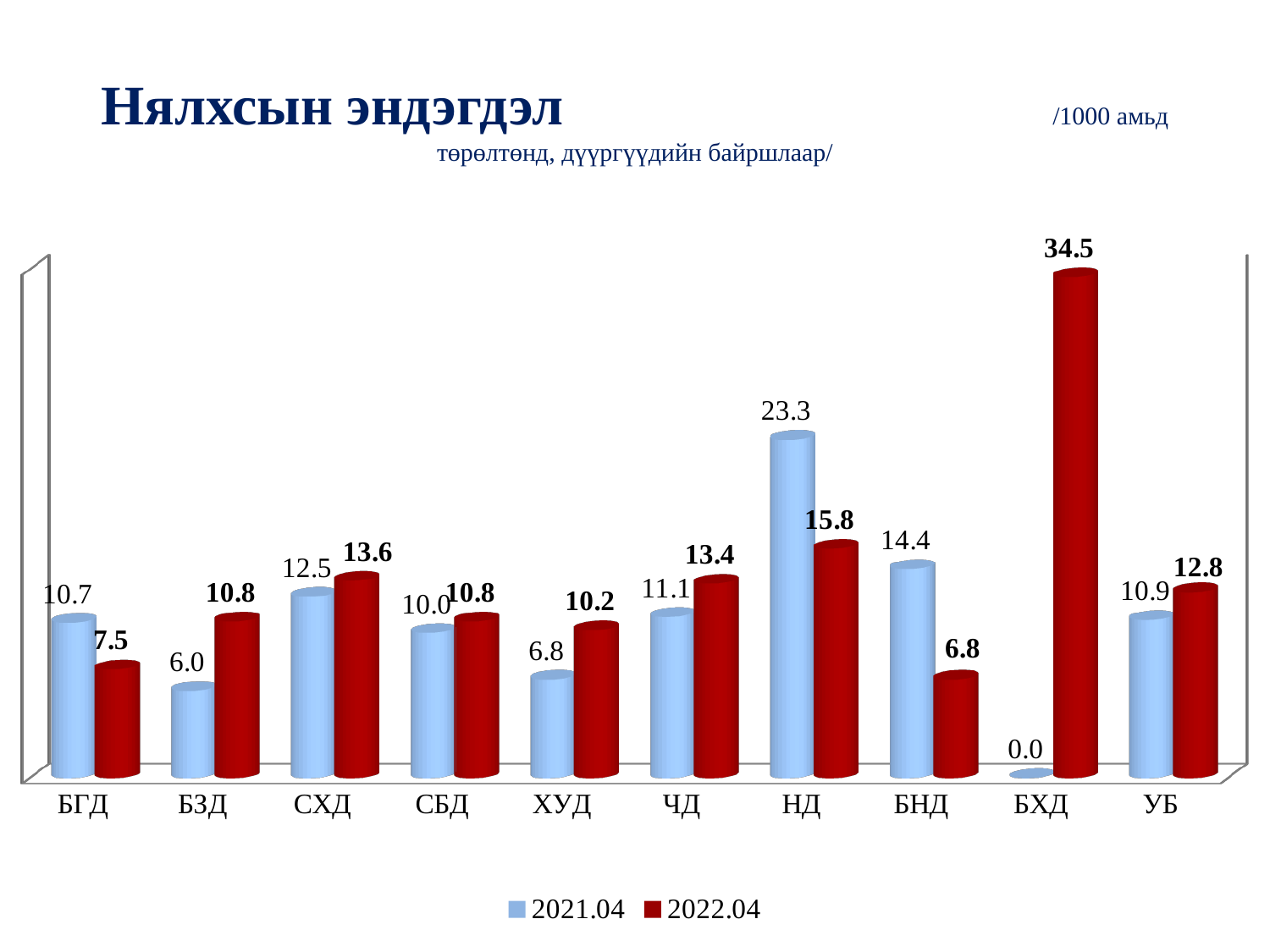
How many districts are shown on the x axis? 10 What is the 2021.04 value for БХД? 0.0 How many series does the legend list? 2 For БНД, which is larger: the 2021.04 value or the 2022.04 value? 2021.04 What is the 2021.04 value for НД? 23.3 Which district has the highest 2022.04 value? БХД What is the difference between the 2021.04 and 2022.04 values for НД? 7.5 What are the two series named in the legend? 2021.04 and 2022.04 What kind of chart is shown on the slide? Bar chart Which district has the lowest 2021.04 value? БХД What is the 2022.04 value for БНД? 6.8 What is the 2022.04 value for БХД? 34.5